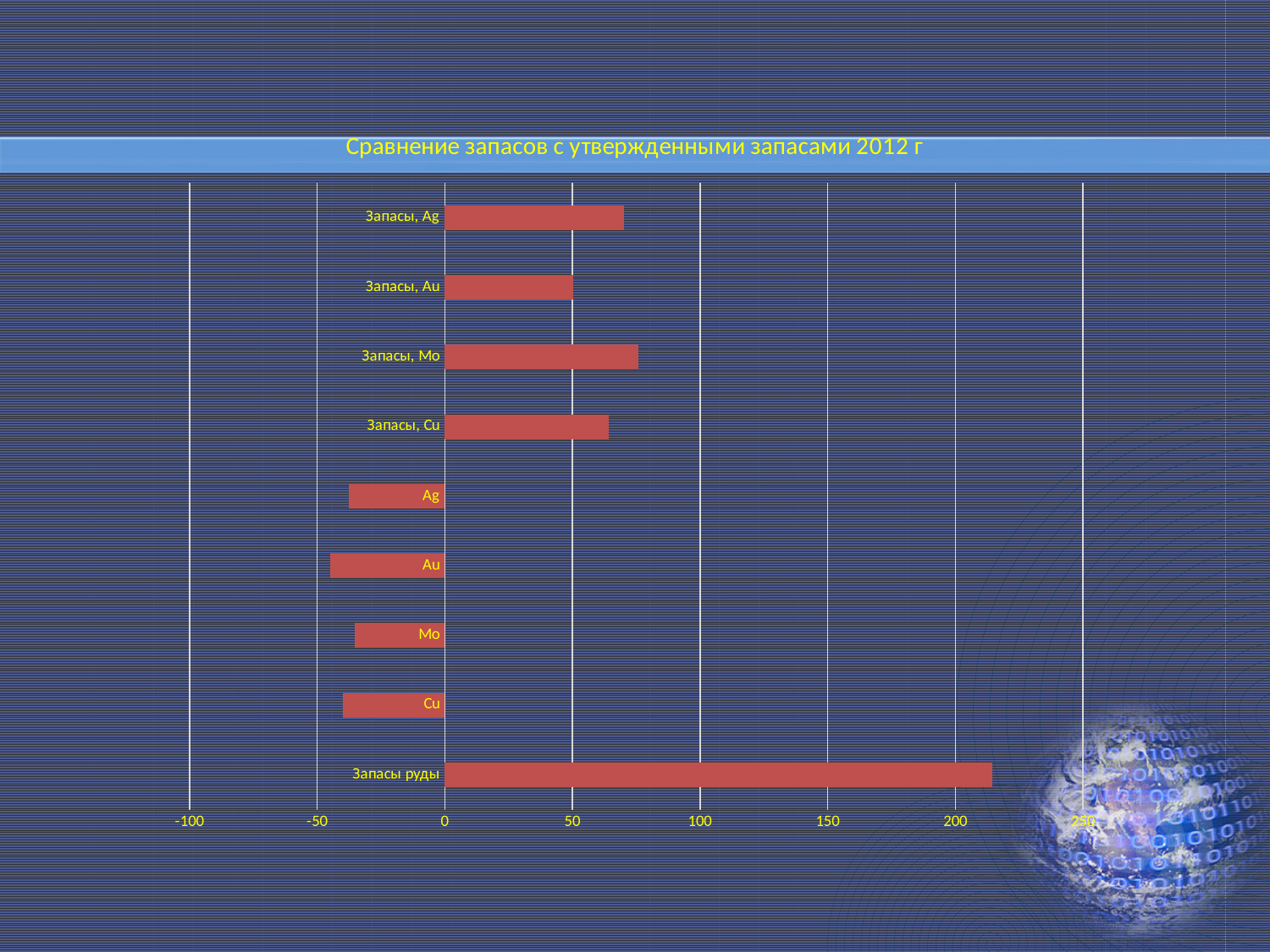
Is the value for Ag greater or less than 0? less Which is larger, the value for Запасы, Mo or the value for Запасы, Au? Запасы, Mo What kind of chart is shown on the slide? bar chart What is the title of the chart? Сравнение запасов с утвержденными запасами 2012 г Which category has the highest value? Запасы руды Is the value for Запасы, Mo greater or less than 100? less Is the value for Запасы, Ag greater or less than 50? greater How many categories are plotted in the chart? 9 Which is larger, the value for Запасы, Cu or the value for Cu? Запасы, Cu